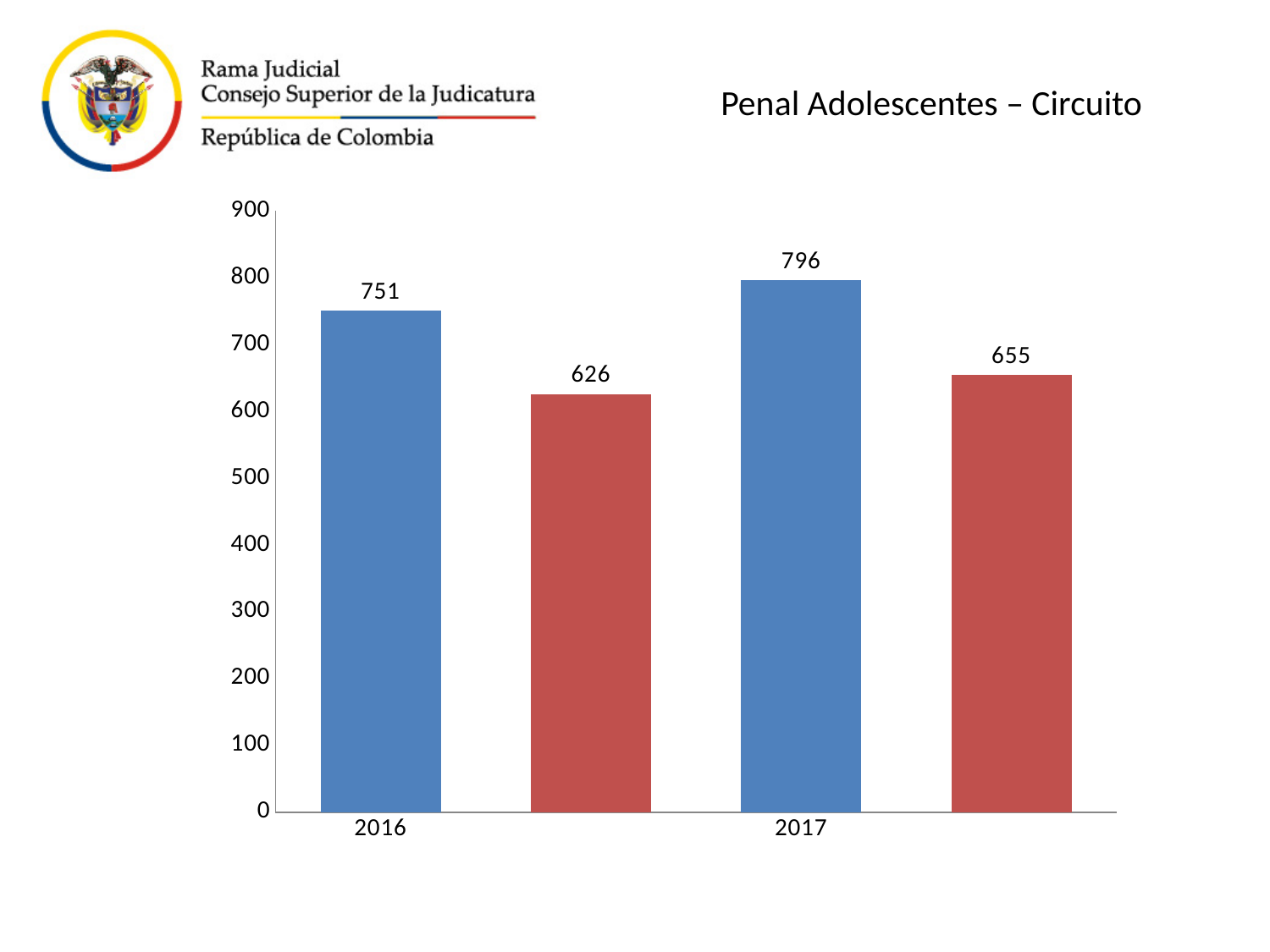
Which is larger, the red bar for 2016 or the red bar for 2017? The red bar for 2017 What is the value of the blue bar for 2016? 751 Do the blue bar values rise or fall from 2016 to 2017? Rise What is the title of the chart? Penal Adolescentes – Circuito Which bar has the lowest value on the chart? The red bar for 2016 (626) What is the value of the red bar for 2017? 655 Which bar has the highest value on the chart? The blue bar for 2017 (796) How many year categories are shown on the x axis? 2 What is the difference between the blue and red bars for 2017? 141 What is the value of the blue bar for 2017? 796 What is the value of the red bar for 2016? 626 What is the difference between the blue bar values for 2017 and 2016? 45